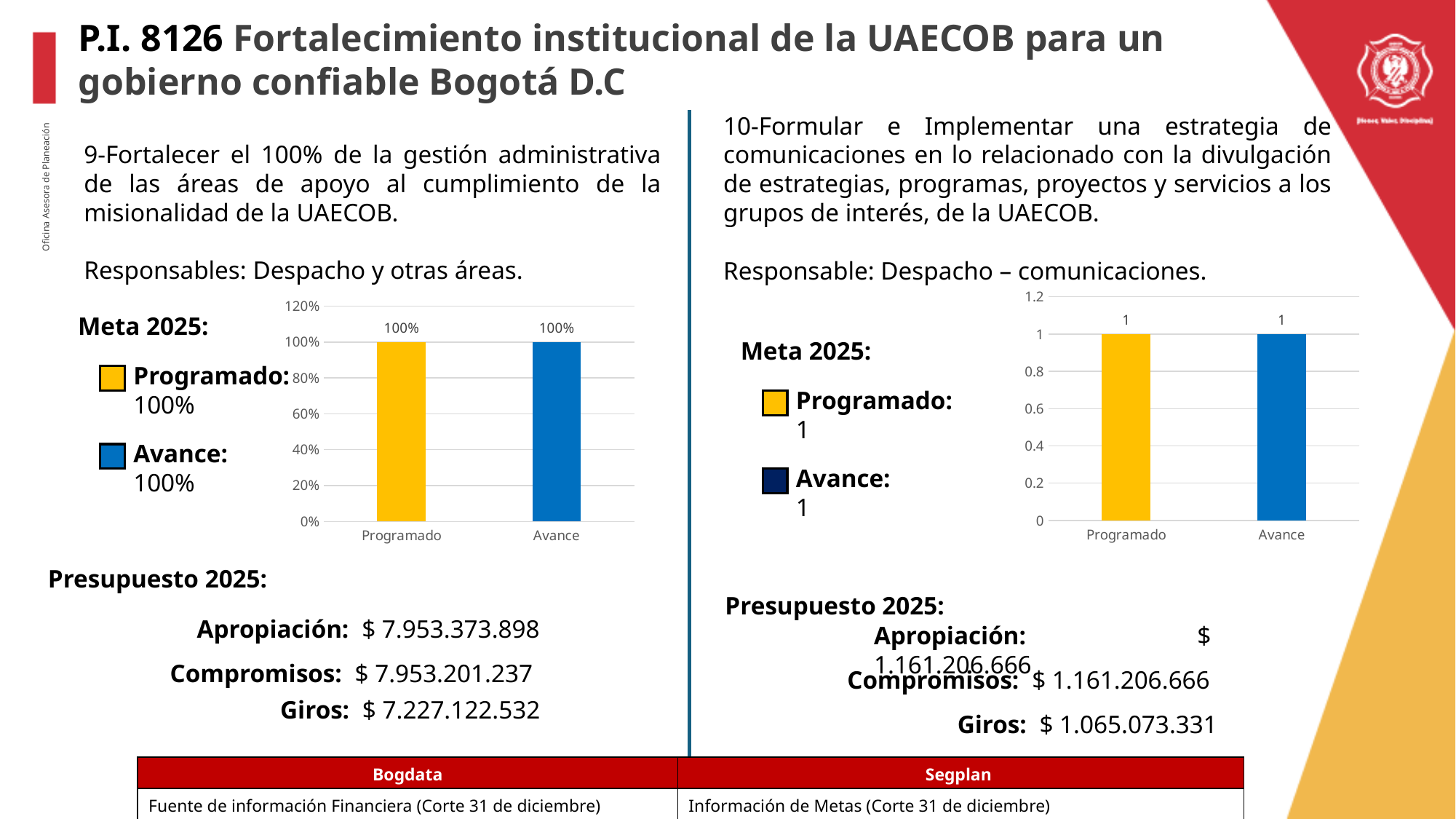
In the left chart, what is the value for Programado? 100% What kind of chart is the left chart? Bar chart What kind of chart is the right chart? Bar chart In the left chart, what is the difference between the Programado and Avance values? 0% How many bars are plotted in the right chart? 2 In the right chart, what is the highest value shown on the vertical axis? 1.2 In the left chart, what is the value for Avance? 100% In the right chart, what is the value for Avance? 1 In the right chart, what is the difference between the Programado and Avance values? 0 In the right chart, what is the value for Programado? 1 In the left chart, is the value for Avance greater or less than 80%? greater How many bars are plotted in the left chart? 2